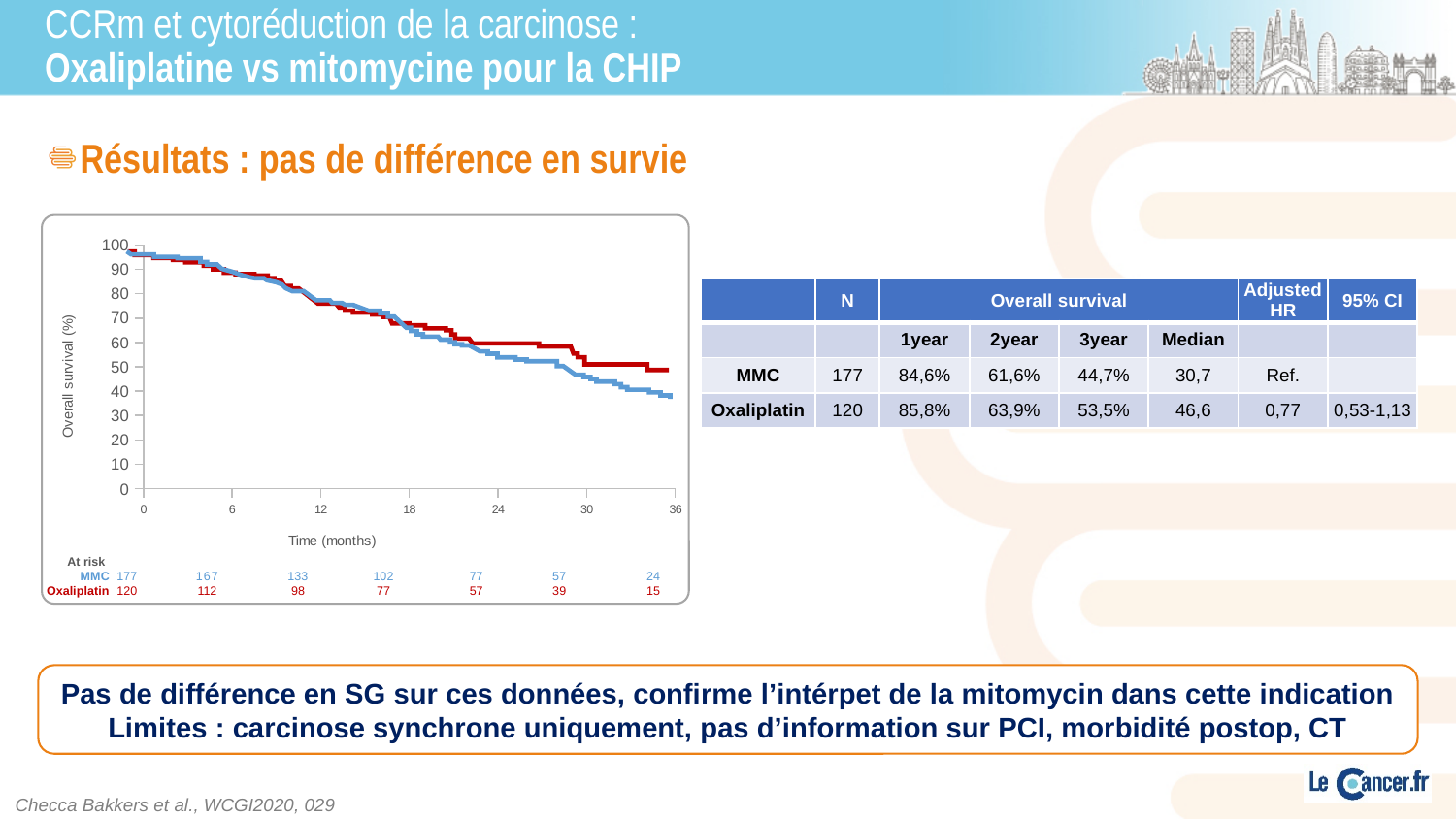
What is the label of the y axis of the survival chart? Overall survival (%) Do the survival curves rise or fall as time increases along the x axis? fall At 36 months, which group has more patients at risk, MMC or Oxaliplatin? MMC How many patients are at risk in the MMC group at time 0? 177 How many time points are listed in the 'At risk' table below the chart? 7 How many patients are at risk in the Oxaliplatin group at 24 months? 57 What kind of chart is shown on the slide? line chart Which colour is used for the Oxaliplatin curve? red At 6 months, how many more patients are at risk in the MMC group than in the Oxaliplatin group? 55 How many patients are at risk in the MMC group at 12 months? 133 How many series (groups) are plotted on the survival chart? 2 Is the overall survival of the MMC curve at 36 months greater or less than 50? less